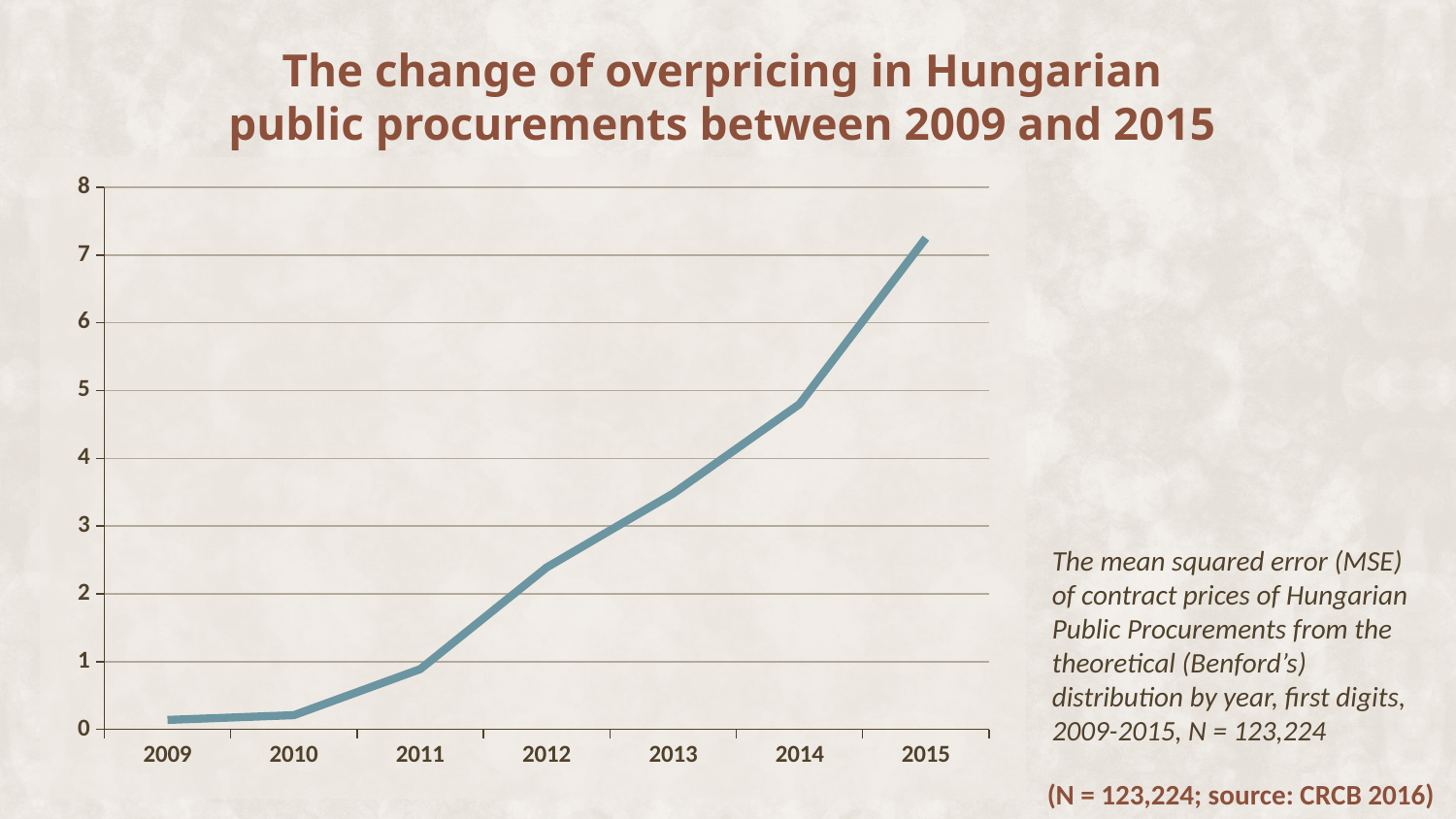
What is the title of the chart on the slide? The change of overpricing in Hungarian public procurements between 2009 and 2015 Do the values rise or fall from 2009 to 2015? rise Is the value for 2013 greater or less than 3? greater Is the value for 2012 greater or less than 2? greater What kind of chart is shown on the slide? line chart How many years are plotted on the x axis? 7 Which year has the highest value on the chart? 2015 Which is larger, the value for 2014 or the value for 2015? 2015 Is the value for 2014 greater or less than 5? less Which is larger, the value for 2011 or the value for 2013? 2013